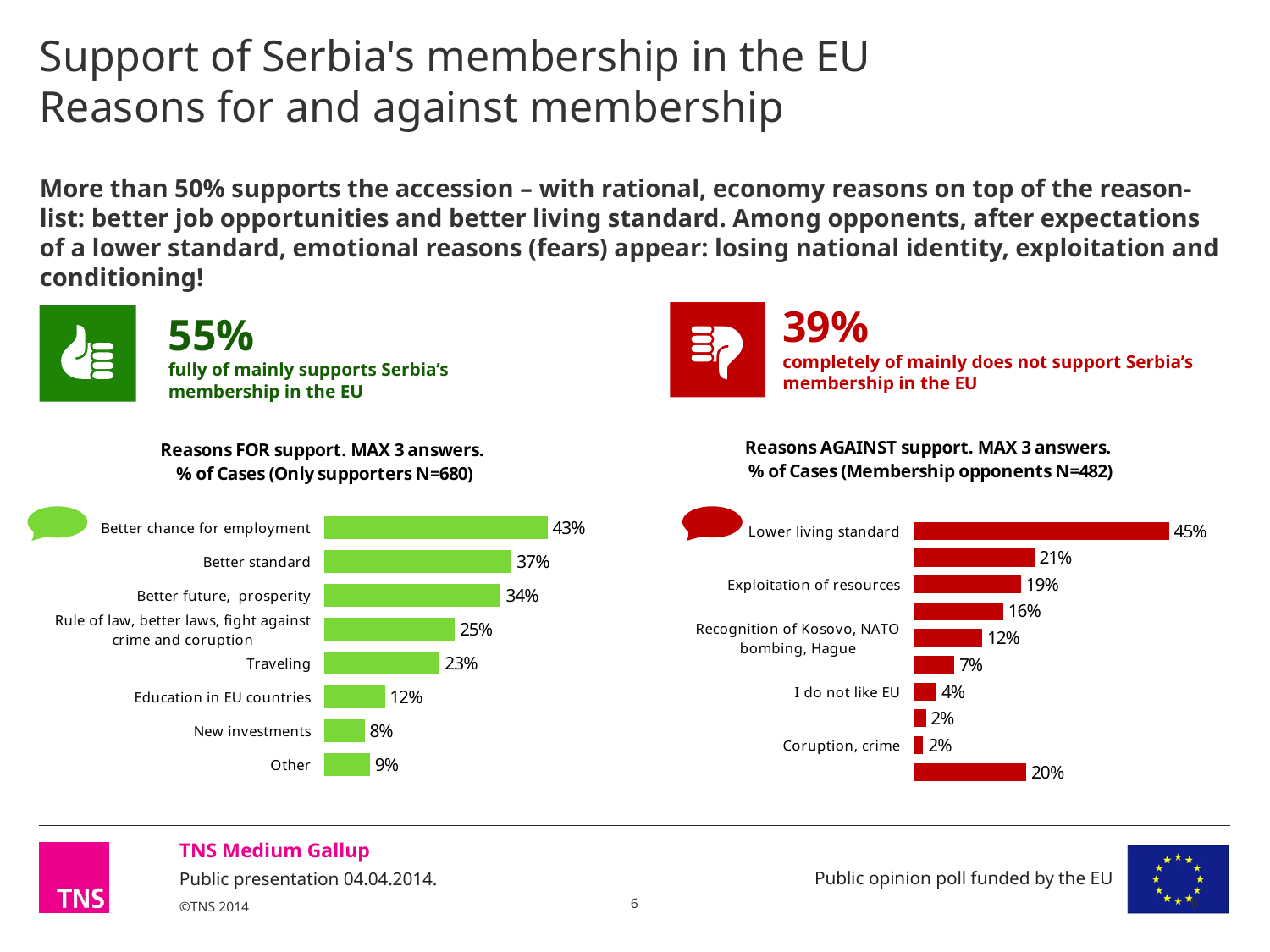
In the 'Reasons FOR support' chart, which reason has the lowest value? New investments In the 'Reasons AGAINST support' chart, which reason has the highest value? Lower living standard How many reasons are listed in the 'Reasons FOR support' chart? 8 In the 'Reasons FOR support' chart, what is the value for Traveling? 23% In the 'Reasons FOR support' chart, which reason has the highest value? Better chance for employment In the 'Reasons AGAINST support' chart, what is the value for Lower living standard? 45% In the 'Reasons FOR support' chart, which is larger: Other or New investments? Other What type of chart is the 'Reasons FOR support' chart? Bar chart In the 'Reasons FOR support' chart, what is the value for Education in EU countries? 12% In the 'Reasons FOR support' chart, what is the difference between Better standard and Better future, prosperity? 3% In the 'Reasons AGAINST support' chart, what is the value for Exploitation of resources? 19% In the 'Reasons FOR support' chart, what is the value for Better chance for employment? 43%